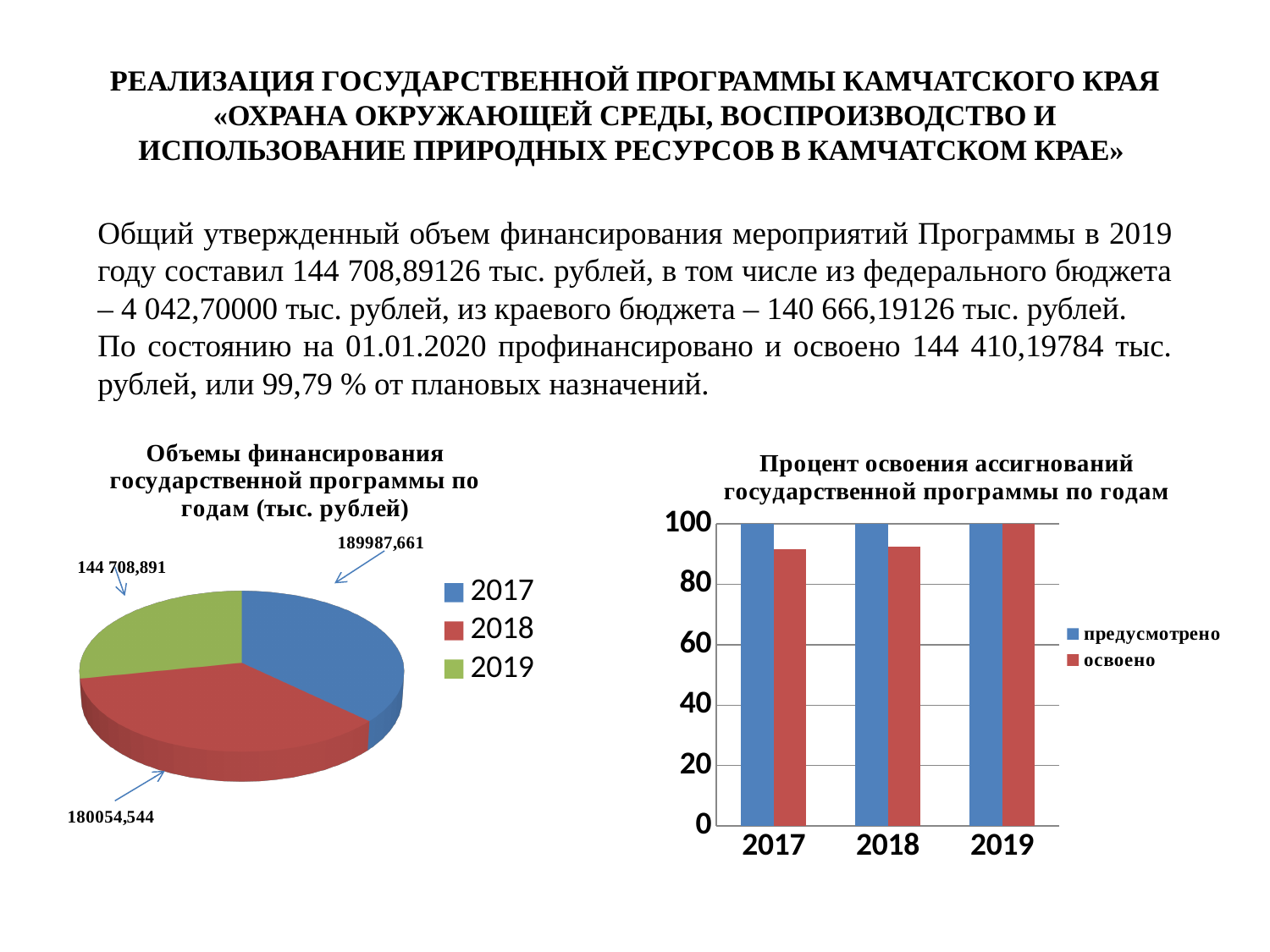
How many slices does the pie chart 'Объемы финансирования государственной программы по годам' have? 3 In the pie chart 'Объемы финансирования государственной программы по годам', which year has the smallest slice? 2019 In the pie chart 'Объемы финансирования государственной программы по годам', what is the value for 2019? 144 708,891 In the pie chart 'Объемы финансирования государственной программы по годам', what is the difference between the values for 2017 and 2018? 9933,117 In the pie chart 'Объемы финансирования государственной программы по годам', which year has the largest slice? 2017 In the pie chart 'Объемы финансирования государственной программы по годам', what is the value for 2017? 189987,661 What kind of chart is the right chart, 'Процент освоения ассигнований государственной программы по годам'? Bar chart In the bar chart 'Процент освоения ассигнований государственной программы по годам', which is larger for 2018: 'предусмотрено' or 'освоено'? предусмотрено How many series does the legend of the bar chart 'Процент освоения ассигнований государственной программы по годам' list? 2 What kind of chart is the left chart, 'Объемы финансирования государственной программы по годам (тыс. рублей)'? Pie chart In the bar chart 'Процент освоения ассигнований государственной программы по годам', is the 'освоено' value for 2017 greater or less than 80? greater What are the two legend entries of the bar chart 'Процент освоения ассигнований государственной программы по годам'? предусмотрено and освоено